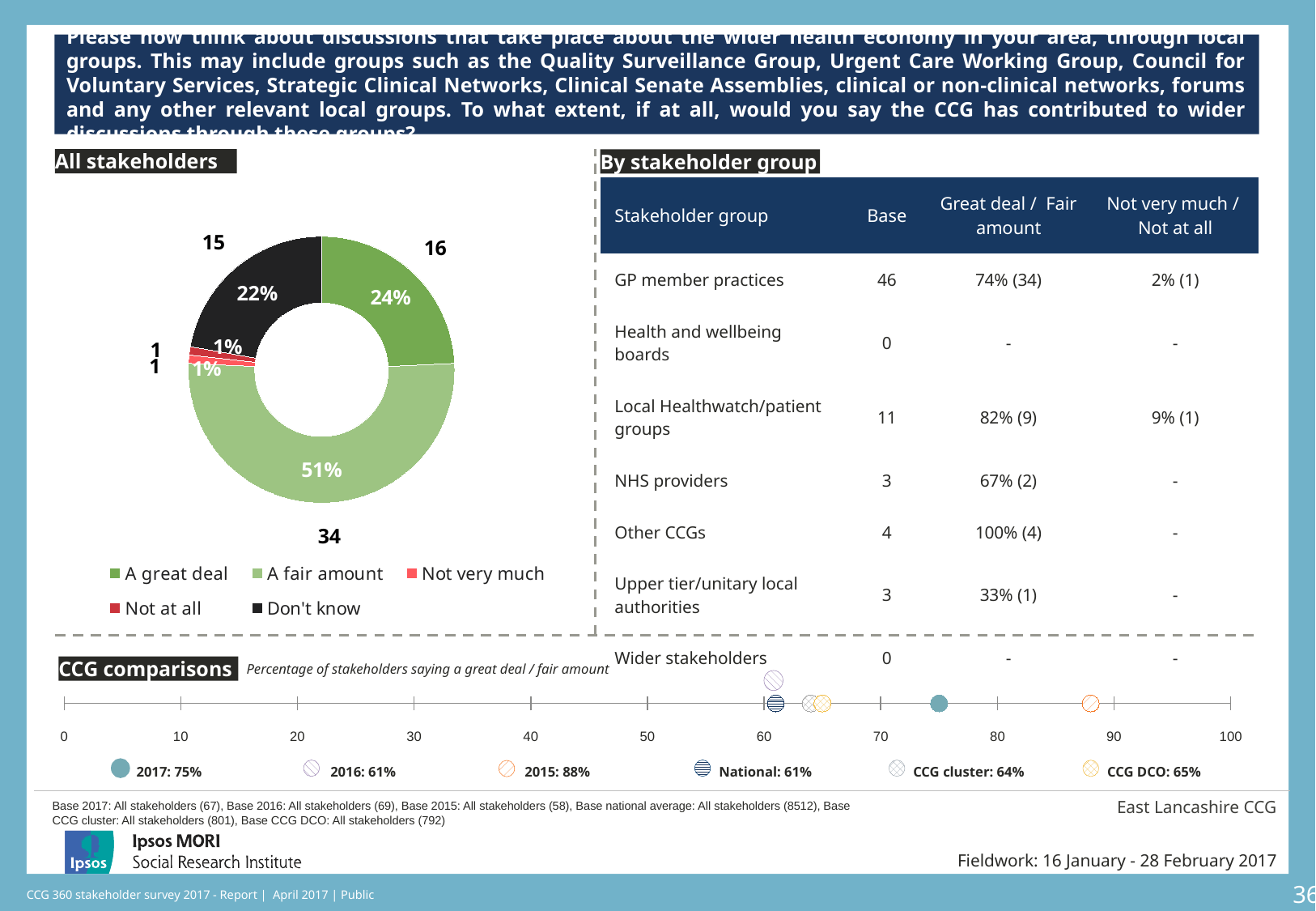
In the 'CCG comparisons' chart, which comparison point has the highest value? 2015: 88% In the 'All stakeholders' chart, how many stakeholders (count) answered 'A fair amount'? 34 What type of chart is the 'All stakeholders' chart? Donut (pie) chart In the 'CCG comparisons' chart, what is the 2017 percentage of stakeholders saying a great deal / fair amount? 75% In the 'All stakeholders' chart, what percentage of stakeholders said 'A great deal'? 24% In the 'All stakeholders' chart, what percentage of stakeholders said 'A fair amount'? 51% In the 'CCG comparisons' chart, what is the difference between the 2017 value and the National value? 14 percentage points In the 'All stakeholders' chart, which is larger: the share for 'Don't know' or the share for 'A great deal'? A great deal In the 'All stakeholders' chart, what percentage of stakeholders answered 'Don't know'? 22% In the 'All stakeholders' chart, which response category has the largest share? A fair amount How many response categories does the legend of the 'All stakeholders' chart list? 5 In the 'All stakeholders' chart, what is the difference in percentage points between 'A fair amount' and 'A great deal'? 27